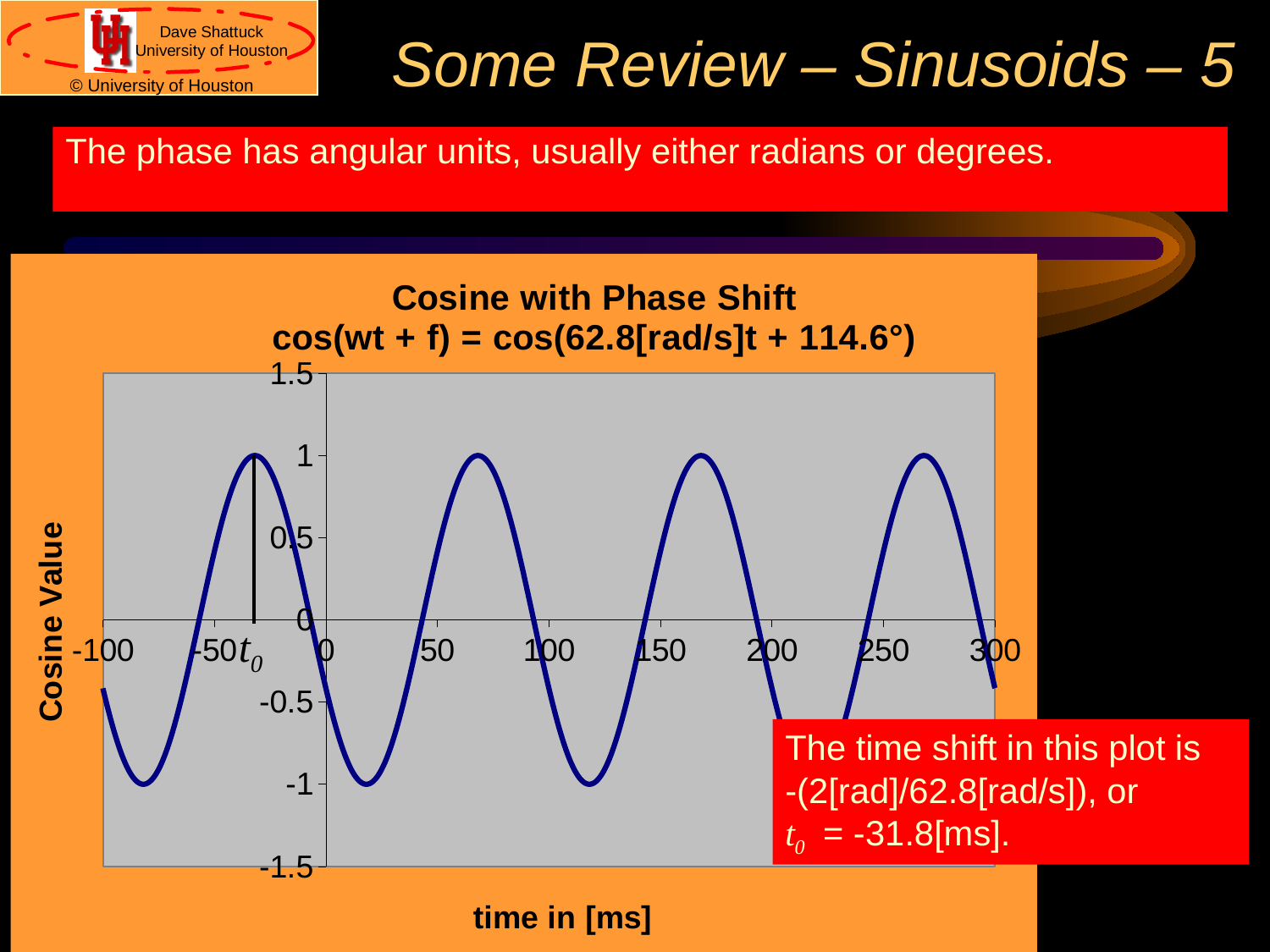
How many peaks of the cosine curve are visible in the plotted range? 4 What is the value of the time shift t0 stated on the slide? -31.8[ms] Is the value of the curve at time 100 ms greater or less than 0? less Is the value of the curve at time 50 ms greater or less than 0? greater What is the largest time value shown on the x axis? 300 What is the title of the chart? Cosine with Phase Shift cos(wt + f) = cos(62.8[rad/s]t + 114.6°) What is the minimum value reached by the cosine curve? -1 What kind of chart is shown on the slide? line chart What is the maximum value reached by the cosine curve? 1 What is the label of the x axis of the chart? time in [ms] Is the value of the curve at time 250 ms greater or less than 0? greater